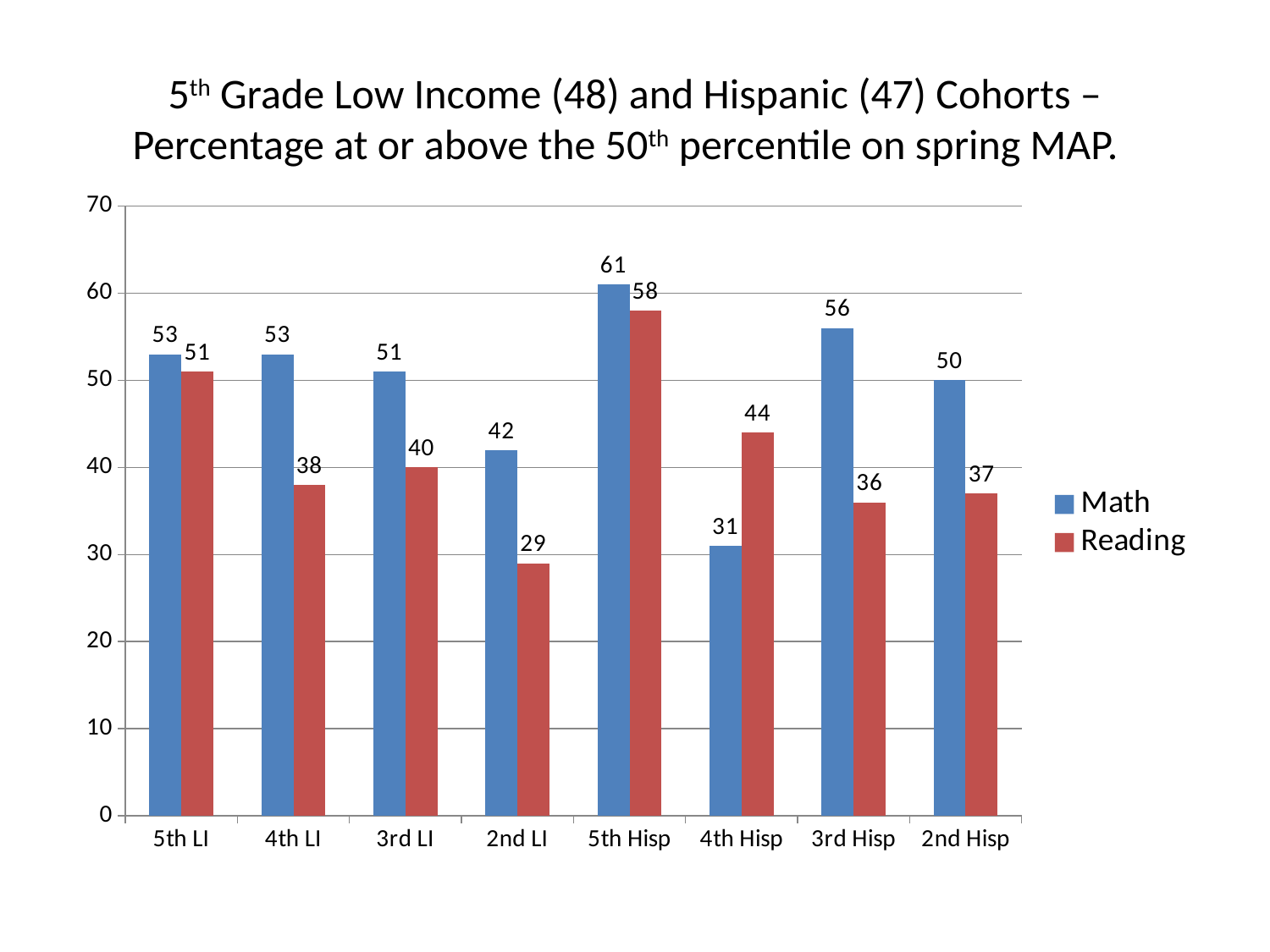
Which category has the lowest Reading value? 2nd LI What is the difference between the Math and Reading values for 3rd Hisp? 20 What kind of chart is shown on the slide? Bar chart Which category has the highest Math value? 5th Hisp How many categories are shown on the x axis? 8 What is the Math value for 2nd Hisp? 50 What is the Math value for 5th Hisp? 61 Which series is shown in red in the legend? Reading How many series does the legend list? 2 Which is larger for 4th Hisp, the Math value or the Reading value? Reading What is the Reading value for 4th Hisp? 44 What is the Reading value for 2nd LI? 29